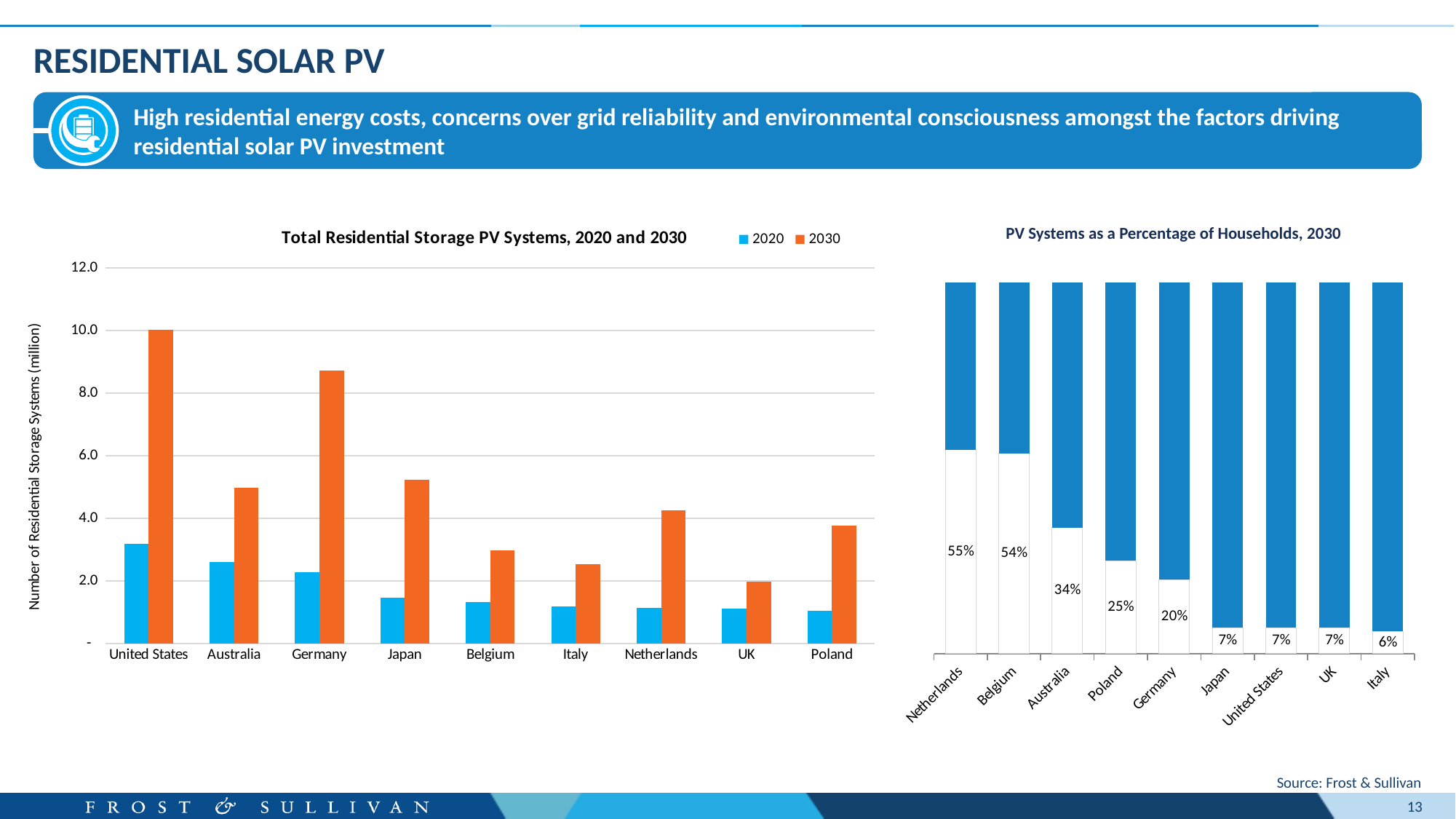
In the chart 'Total Residential Storage PV Systems, 2020 and 2030', is the 2030 value for Germany greater or less than 8.0? greater In the chart 'Total Residential Storage PV Systems, 2020 and 2030', which country has the highest 2030 value? United States In the chart 'PV Systems as a Percentage of Households, 2030', which country has the lowest percentage? Italy In the chart 'PV Systems as a Percentage of Households, 2030', do the values rise or fall from left to right? fall What kind of chart is 'Total Residential Storage PV Systems, 2020 and 2030'? bar chart In the chart 'Total Residential Storage PV Systems, 2020 and 2030', how many countries are shown on the x axis? 9 In the chart 'PV Systems as a Percentage of Households, 2030', what is the value for Germany? 20% In the chart 'PV Systems as a Percentage of Households, 2030', which country has the highest percentage? Netherlands In the chart 'PV Systems as a Percentage of Households, 2030', what is the difference between the values for Netherlands and Australia? 21% In the chart 'Total Residential Storage PV Systems, 2020 and 2030', how many series does the legend list? 2 In the chart 'PV Systems as a Percentage of Households, 2030', what is the value for Australia? 34% In the chart 'Total Residential Storage PV Systems, 2020 and 2030', which is larger: the 2030 value for Australia or the 2030 value for Japan? Japan